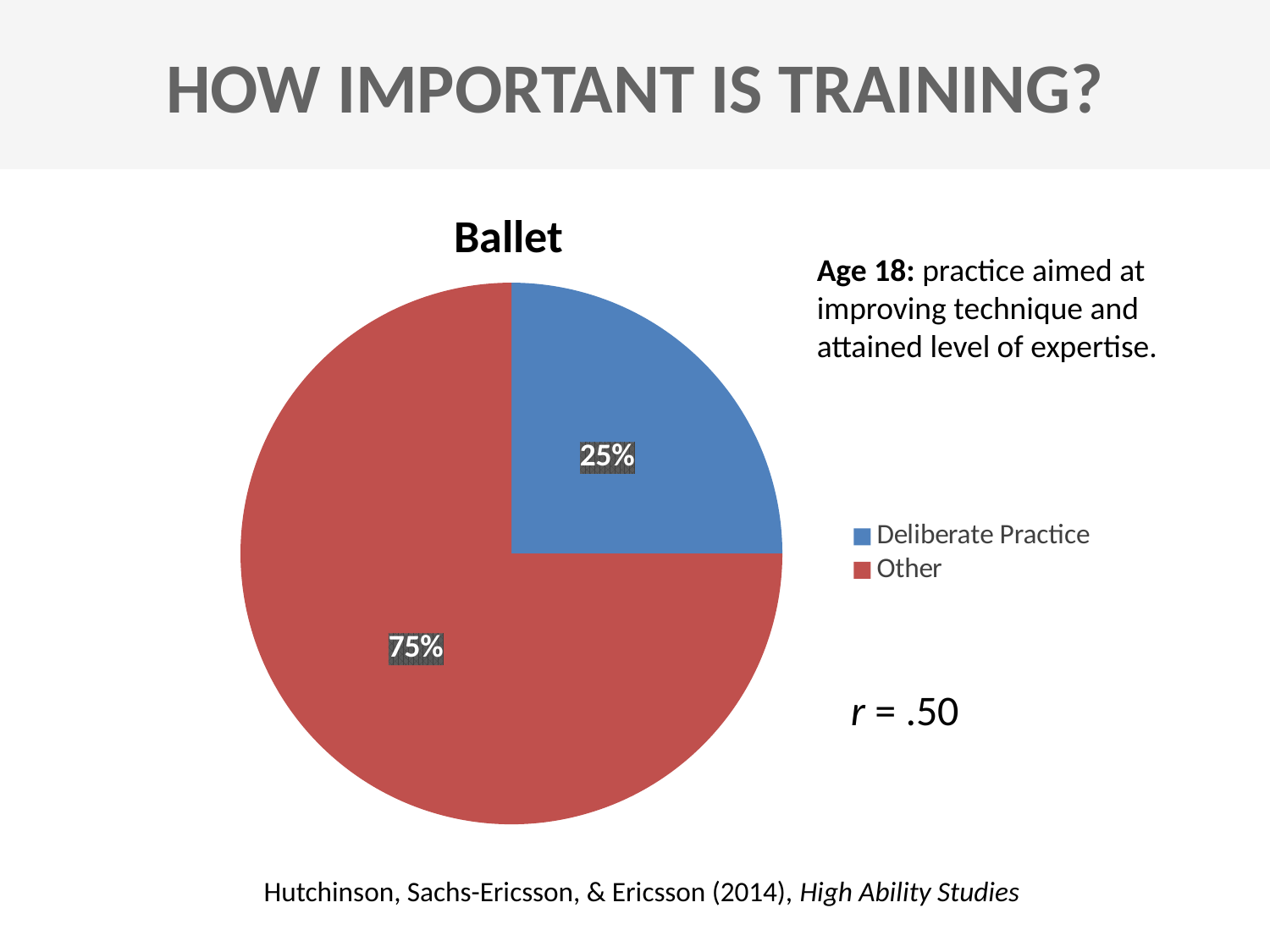
Which is larger, the Deliberate Practice slice or the Other slice? Other How many slices does the pie chart have? 2 What is the difference between the Other share and the Deliberate Practice share? 50% Is the Deliberate Practice share greater or less than 50%? less Which slice is the largest? Other What is the title of the chart? Ballet Which slice is the smallest? Deliberate Practice How many entries does the legend list? 2 What colour is the Deliberate Practice slice? blue What share of the pie is Other? 75% What kind of chart is shown on the slide? pie chart What share of the pie is Deliberate Practice? 25%